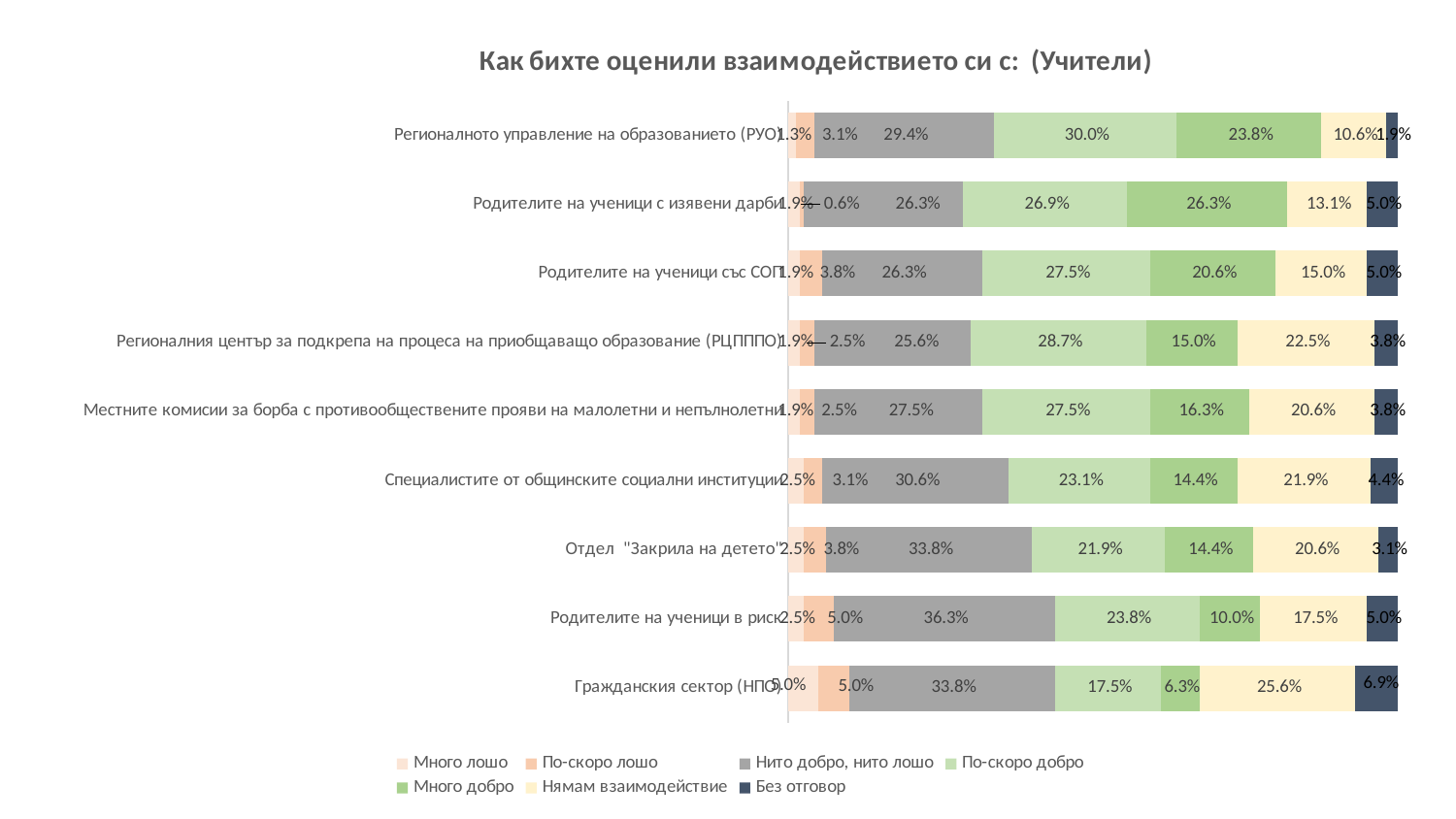
What kind of chart is shown on the slide? Stacked bar chart What is the difference between the 'Нямам взаимодействие' values for 'Регионалния център за подкрепа на процеса на приобщаващо образование (РЦПППО)' and 'Регионалното управление на образованието (РУО)'? 11.9% What is the 'Нямам взаимодействие' value for 'Гражданския сектор (НПО)'? 25.6% Which is larger: the 'Много добро' value for 'Родителите на ученици с изявени дарби' or for 'Отдел "Закрила на детето"'? Родителите на ученици с изявени дарби What is the title of the chart? Как бихте оценили взаимодействието си с: (Учители) Which category has the highest 'Нито добро, нито лошо' value? Родителите на ученици в риск What is the 'По-скоро добро' value for 'Родителите на ученици със СОП'? 27.5% How many series does the legend list? 7 Which category has the lowest 'Много добро' value? Гражданския сектор (НПО) How many categories (rows) are plotted in the chart? 9 What is the 'Нито добро, нито лошо' value for 'Родителите на ученици в риск'? 36.3% What is the 'Много добро' value for 'Регионалното управление на образованието (РУО)'? 23.8%